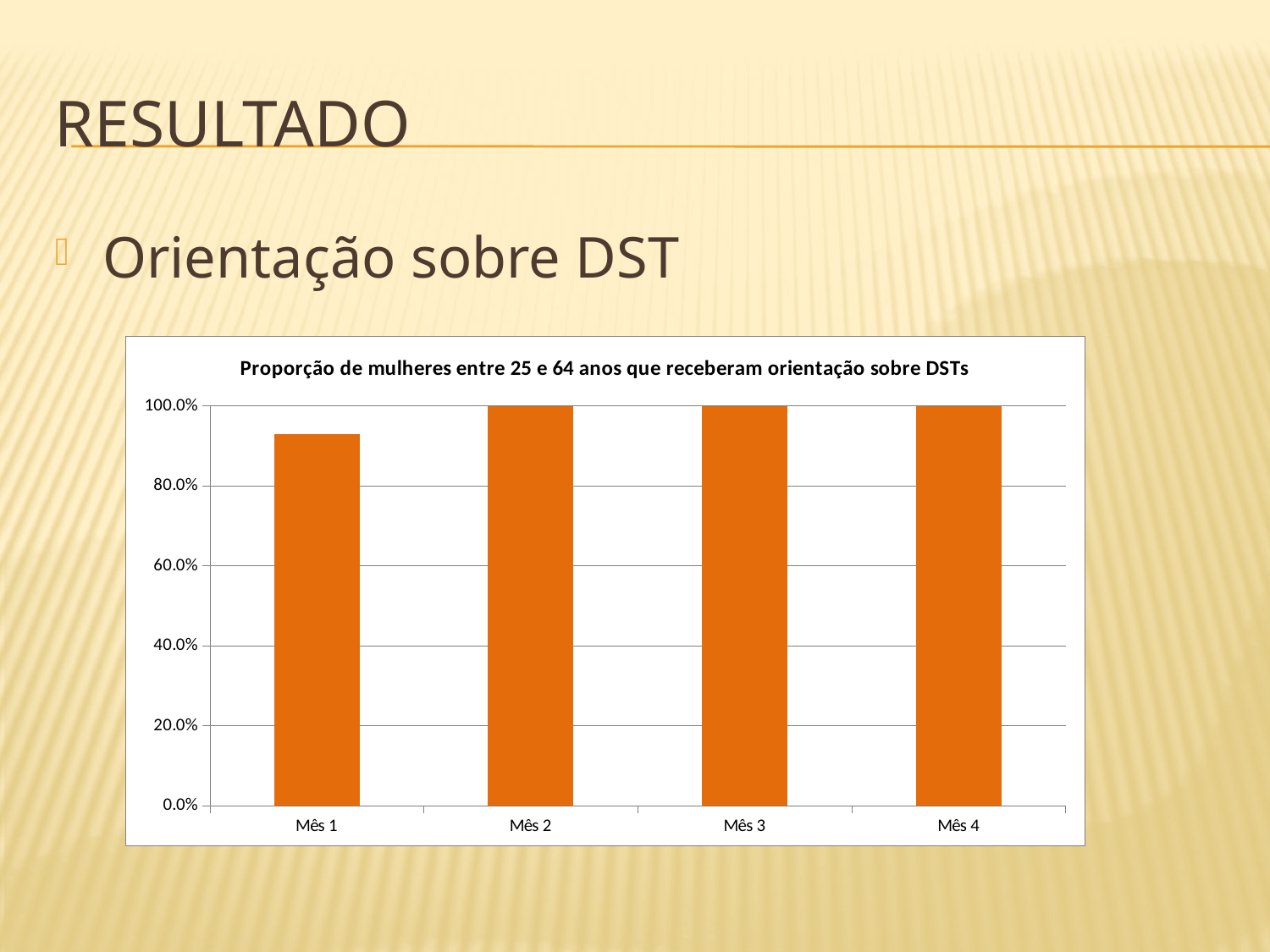
Does the value rise or fall from Mês 1 to Mês 2? rise What is the value for Mês 4 in the chart? 100.0% What colour are the bars in the chart? orange What kind of chart is shown on the slide? bar chart What is the value for Mês 3 in the chart? 100.0% Is the value for Mês 1 greater or less than 80.0%? greater Which month has the lowest value in the chart? Mês 1 Is the value for Mês 1 greater or less than 100.0%? less What is the title of the chart? Proporção de mulheres entre 25 e 64 anos que receberam orientação sobre DSTs How many months (categories) are shown on the x axis of the chart? 4 What is the value for Mês 2 in the chart? 100.0% Which is larger, the value for Mês 1 or the value for Mês 2? Mês 2